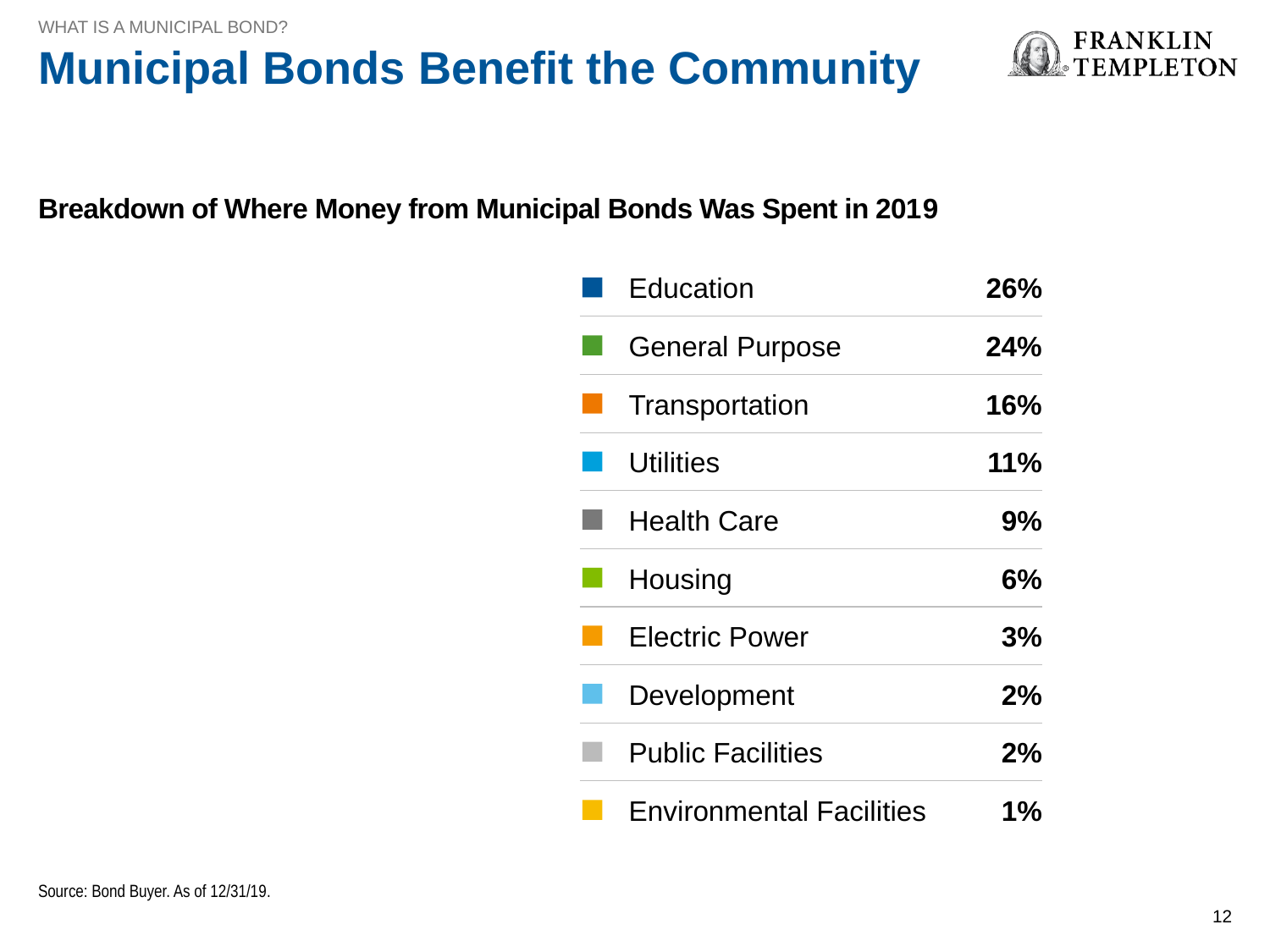
Which is larger, the share for Housing or the share for Electric Power? Housing What percentage is shown for Health Care? 9% What percentage is shown for Environmental Facilities? 1% Which is larger, the share for Utilities or the share for Health Care? Utilities What is the difference in percentage points between Transportation and Utilities? 5 What is the difference in percentage points between Education and General Purpose? 2 Which category received the smallest share of municipal bond spending in 2019? Environmental Facilities Which category received the largest share of municipal bond spending in 2019? Education What percentage of municipal bond money was spent on Education in 2019? 26% How many spending categories are listed in the legend? 10 What percentage is shown for Transportation? 16% What is the title of the breakdown shown on the slide? Breakdown of Where Money from Municipal Bonds Was Spent in 2019